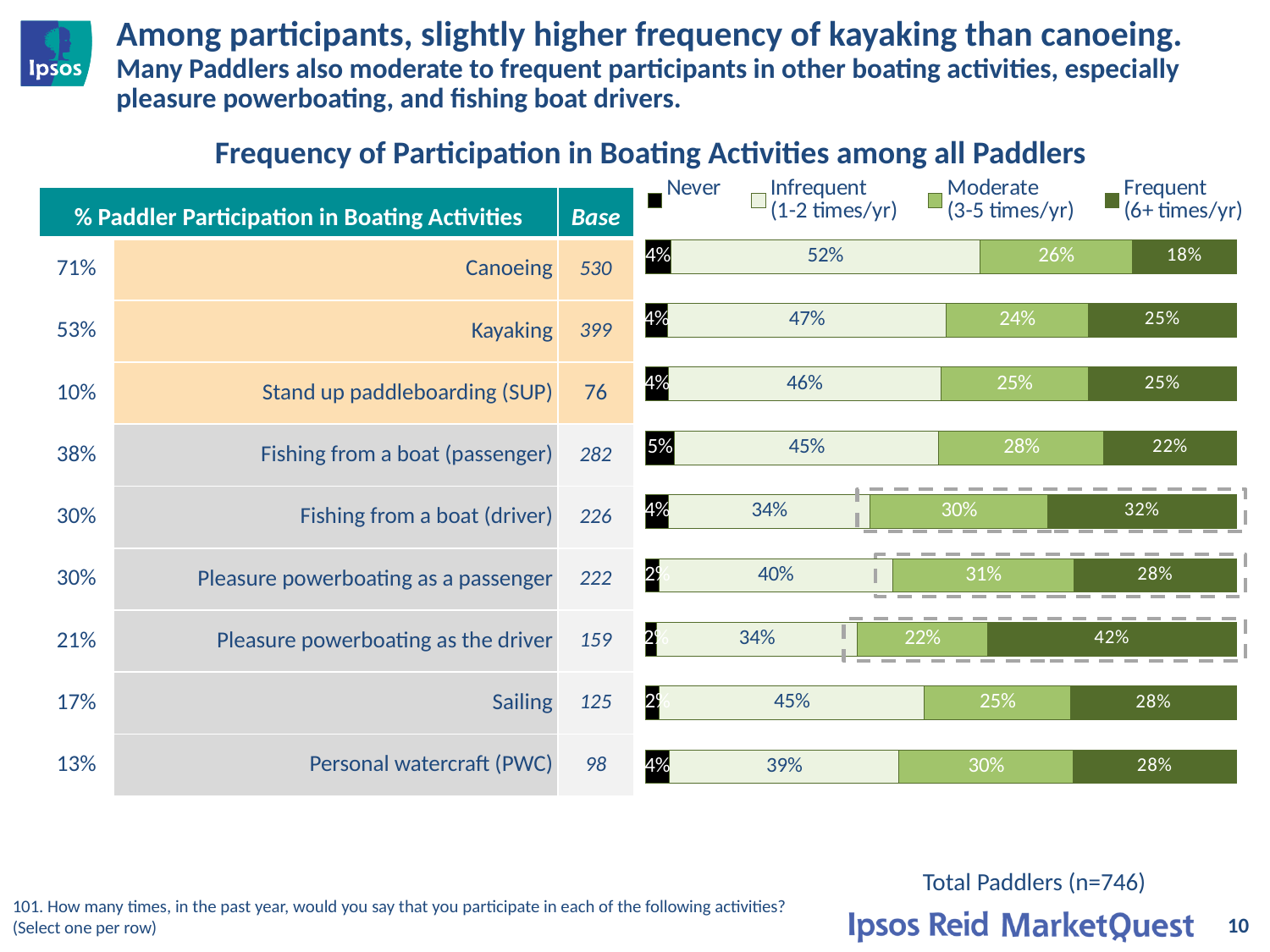
Which activity has the highest Frequent (6+ times/yr) value? Pleasure powerboating as the driver Which has a larger Moderate (3-5 times/yr) value: Fishing from a boat (driver) or Canoeing? Fishing from a boat (driver) What is the total of the stacked bar for Canoeing? 100% What percentage of paddlers report Infrequent (1-2 times/yr) participation in Canoeing? 52% What is the Frequent (6+ times/yr) value for Pleasure powerboating as the driver? 42% Which activity has the lowest Frequent (6+ times/yr) value? Canoeing What is the Moderate (3-5 times/yr) value for Fishing from a boat (driver)? 30% Which activity has the highest Infrequent (1-2 times/yr) value? Canoeing What kind of chart is used to show frequency of participation? Stacked bar chart How many boating activities are shown in the chart? 9 What is the difference between the Frequent (6+ times/yr) values for Kayaking and Canoeing? 7 percentage points How many series does the legend list? 4